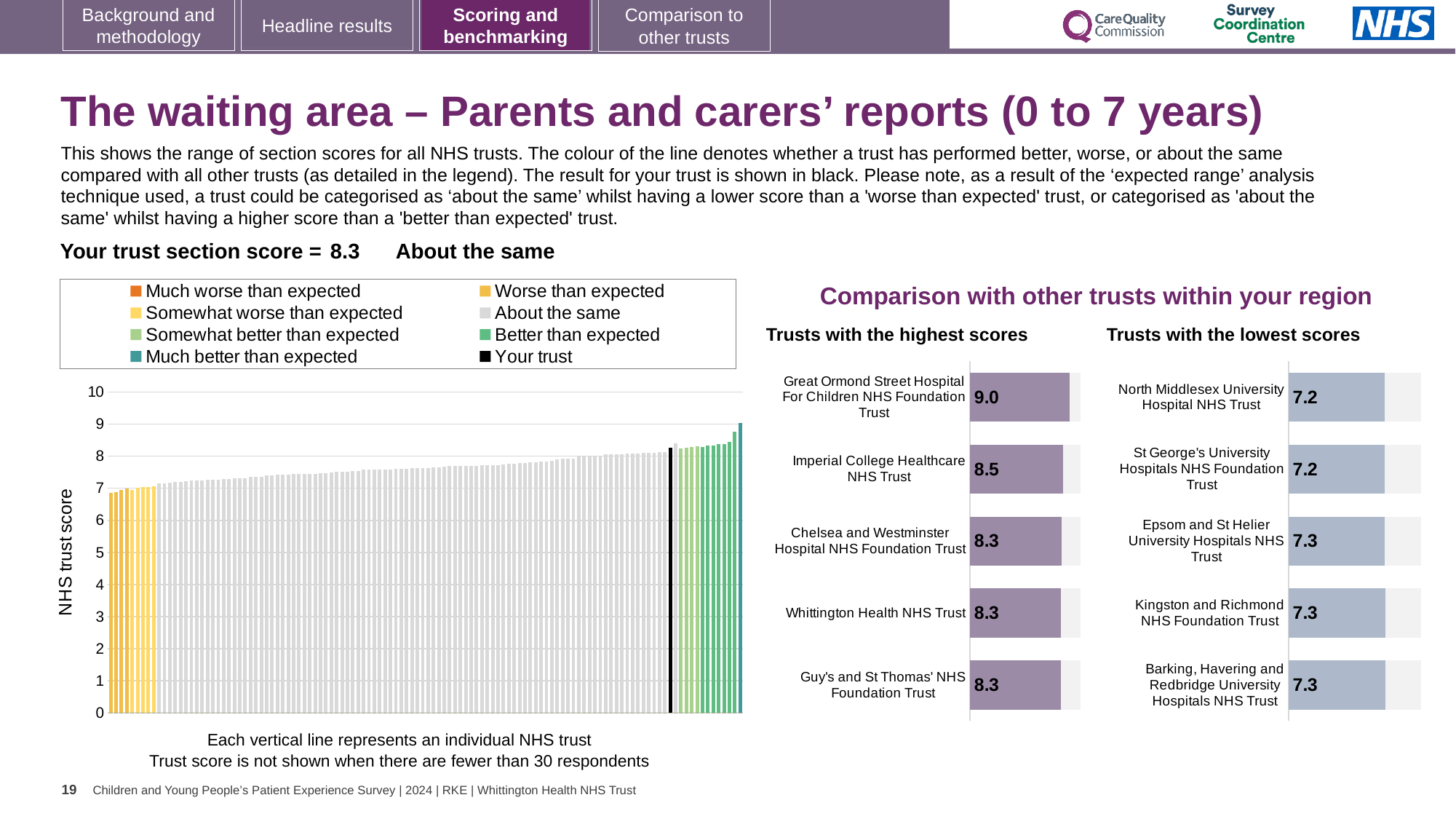
What type of chart is the main 'NHS trust score' chart on the left of the slide? Bar chart How many entries does the legend of the main 'NHS trust score' chart on the left list? 8 In the 'Trusts with the lowest scores' chart, what is the score for Barking, Havering and Redbridge University Hospitals NHS Trust? 7.3 How many trusts are shown in the 'Trusts with the highest scores' chart? 5 In the 'Trusts with the highest scores' chart, which trust has the highest score? Great Ormond Street Hospital For Children NHS Foundation Trust In the 'Trusts with the lowest scores' chart, what is the score for North Middlesex University Hospital NHS Trust? 7.2 In the main 'NHS trust score' chart on the left, do the bar values rise or fall from left to right? Rise In the 'Trusts with the highest scores' chart, what is the score for Imperial College Healthcare NHS Trust? 8.5 Which has the larger score: Imperial College Healthcare NHS Trust in the highest scores chart or Kingston and Richmond NHS Foundation Trust in the lowest scores chart? Imperial College Healthcare NHS Trust In the 'Trusts with the lowest scores' chart, what is the difference between the scores of Epsom and St Helier University Hospitals NHS Trust and North Middlesex University Hospital NHS Trust? 0.1 In the 'Trusts with the highest scores' chart, what is the score for Great Ormond Street Hospital For Children NHS Foundation Trust? 9.0 In the 'Trusts with the highest scores' chart, what is the difference between the scores of Great Ormond Street Hospital For Children NHS Foundation Trust and Imperial College Healthcare NHS Trust? 0.5